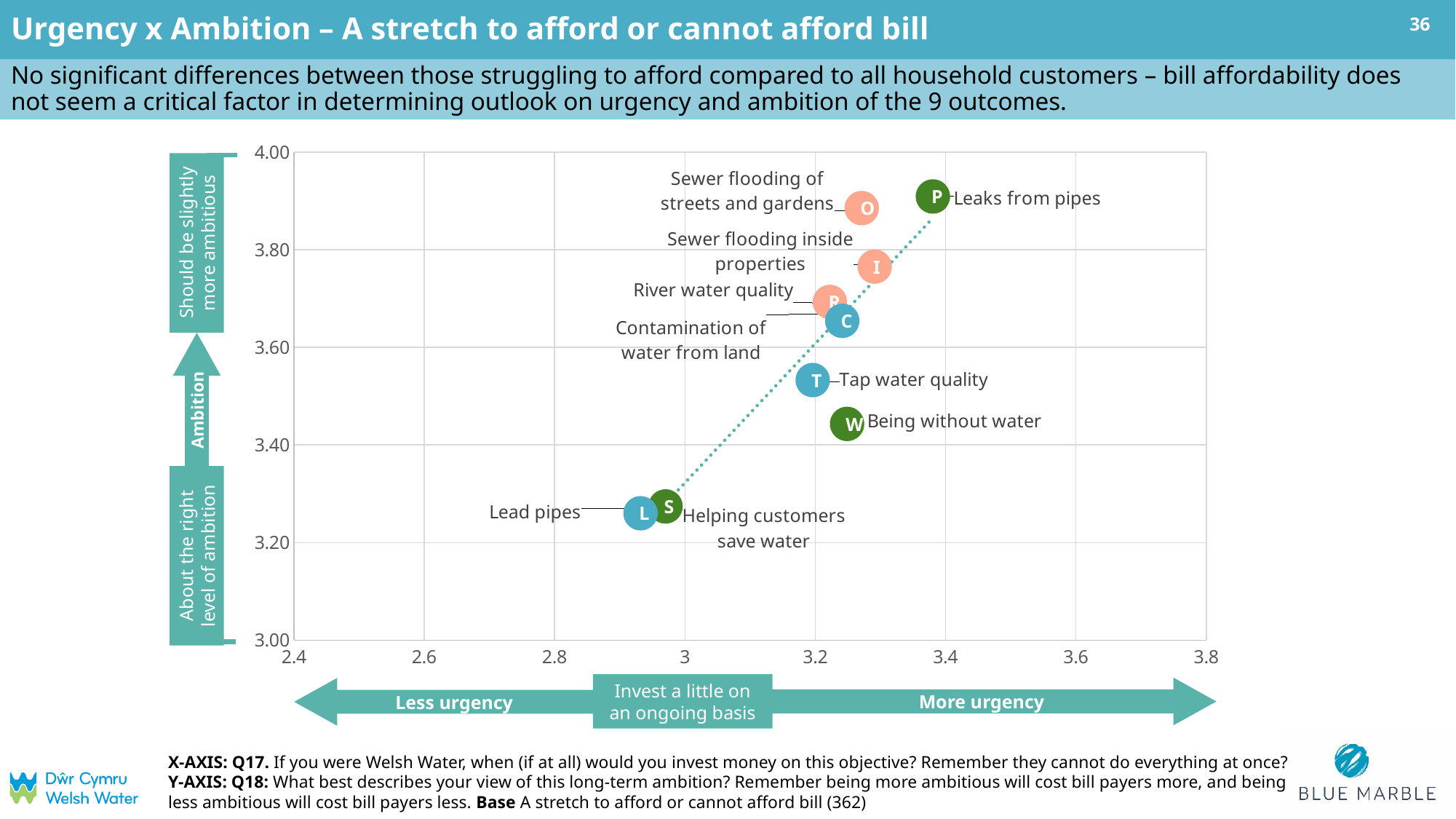
Is the ambition value for Leaks from pipes greater or less than 3.80? greater Is the ambition value for Being without water greater or less than 3.60? less Is the urgency value for Sewer flooding inside properties greater or less than 3.2? greater Which has the higher ambition value, Tap water quality or Being without water? Tap water quality What is the title of the chart slide? Urgency x Ambition – A stretch to afford or cannot afford bill Which outcome has the lowest urgency (furthest left on the x axis)? Lead pipes How many outcomes are plotted on the chart? 9 As urgency increases along the x axis, does ambition generally rise or fall? Rise Which outcome has the highest urgency (furthest right on the x axis)? Leaks from pipes What kind of chart is shown on the slide? Scatter chart